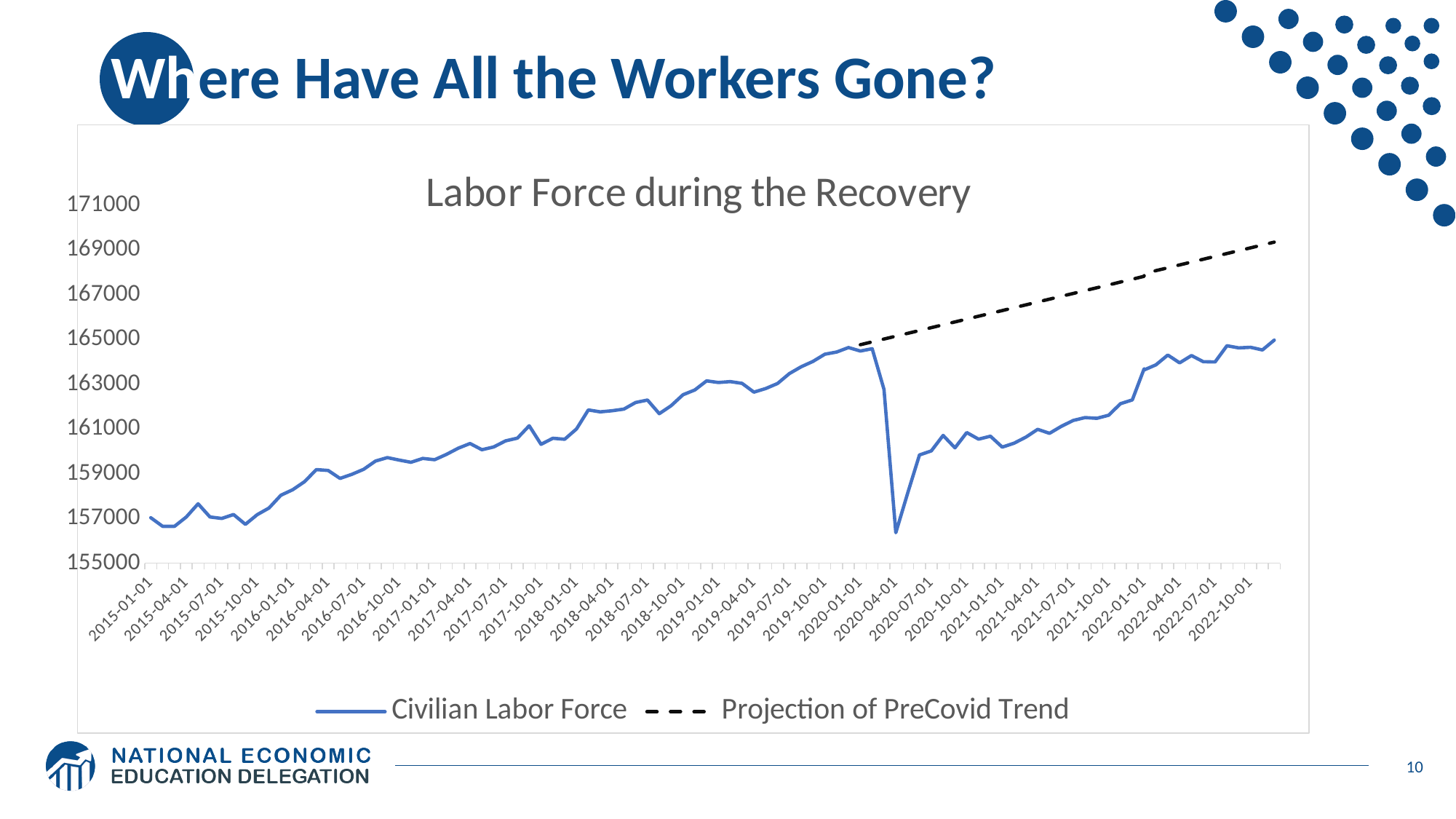
How many series does the chart's legend list? 2 Which series is drawn with a dashed line? Projection of PreCovid Trend Is the Projection of PreCovid Trend value at the end of the series (2022-10-01) greater or less than 167000? greater Is the Civilian Labor Force value at 2015-10-01 greater or less than 159000? less Does the Civilian Labor Force generally rise or fall from 2015-01-01 to 2020-01-01? Rise What type of chart is shown on the slide? Line chart Is the Civilian Labor Force value at 2021-01-01 greater or less than 161000? less What is the title of the chart? Labor Force during the Recovery Around which date does the Civilian Labor Force series reach its lowest point? 2020-04-01 At the end of the chart (2022-10-01), which is higher: the Civilian Labor Force or the Projection of PreCovid Trend? Projection of PreCovid Trend